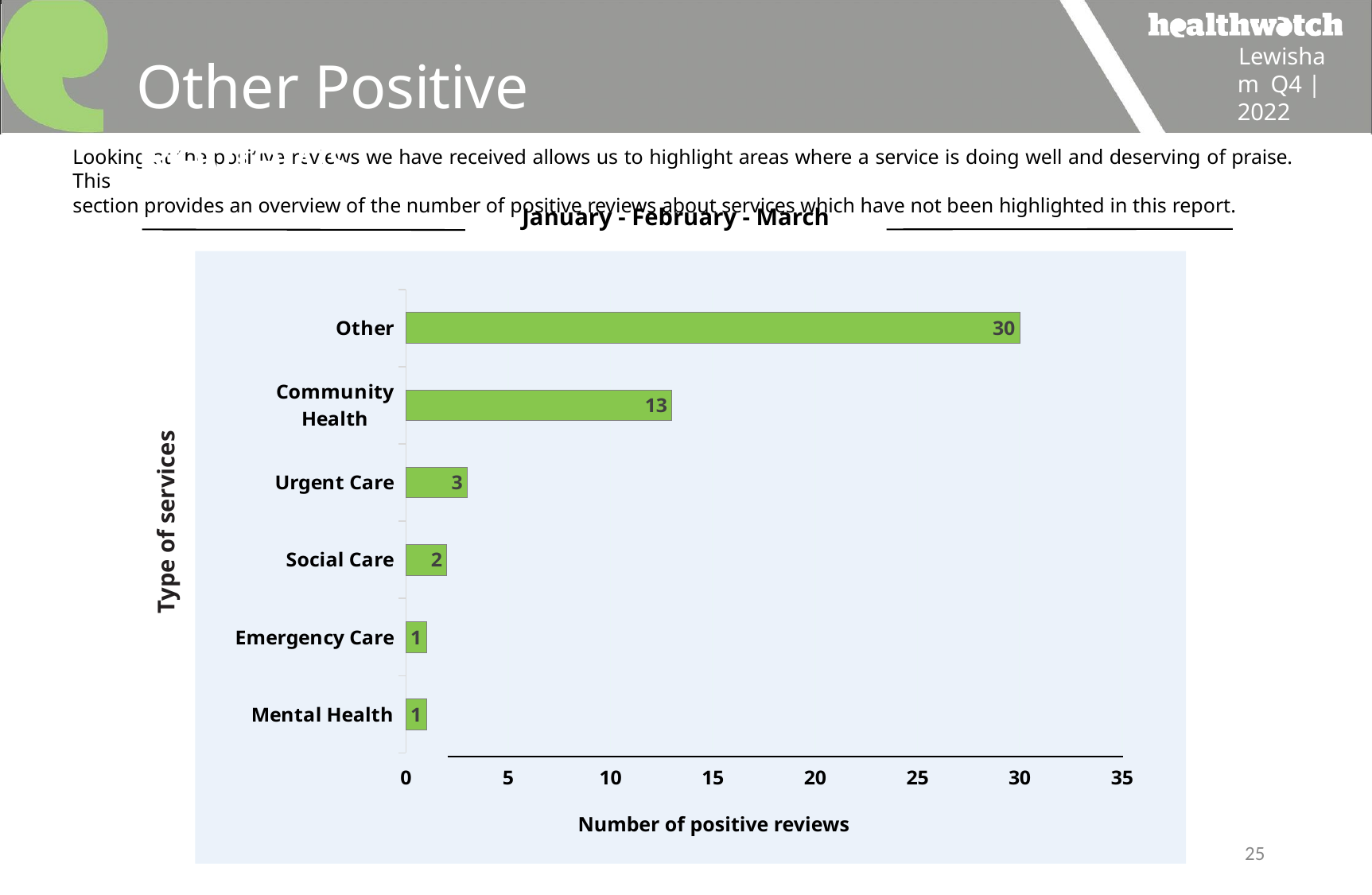
Which type of service has the highest number of positive reviews? Other What is the number of positive reviews for Community Health? 13 What is the label of the horizontal axis? Number of positive reviews How many types of services are shown in the chart? 6 What is the number of positive reviews for Social Care? 2 What is the title of the chart? January - February - March Which has more positive reviews, Urgent Care or Social Care? Urgent Care What kind of chart is shown on the slide? Bar chart What is the difference in positive reviews between Urgent Care and Emergency Care? 2 What is the difference in positive reviews between Other and Community Health? 17 What is the number of positive reviews for Urgent Care? 3 Is the value for Community Health greater or less than 10? greater